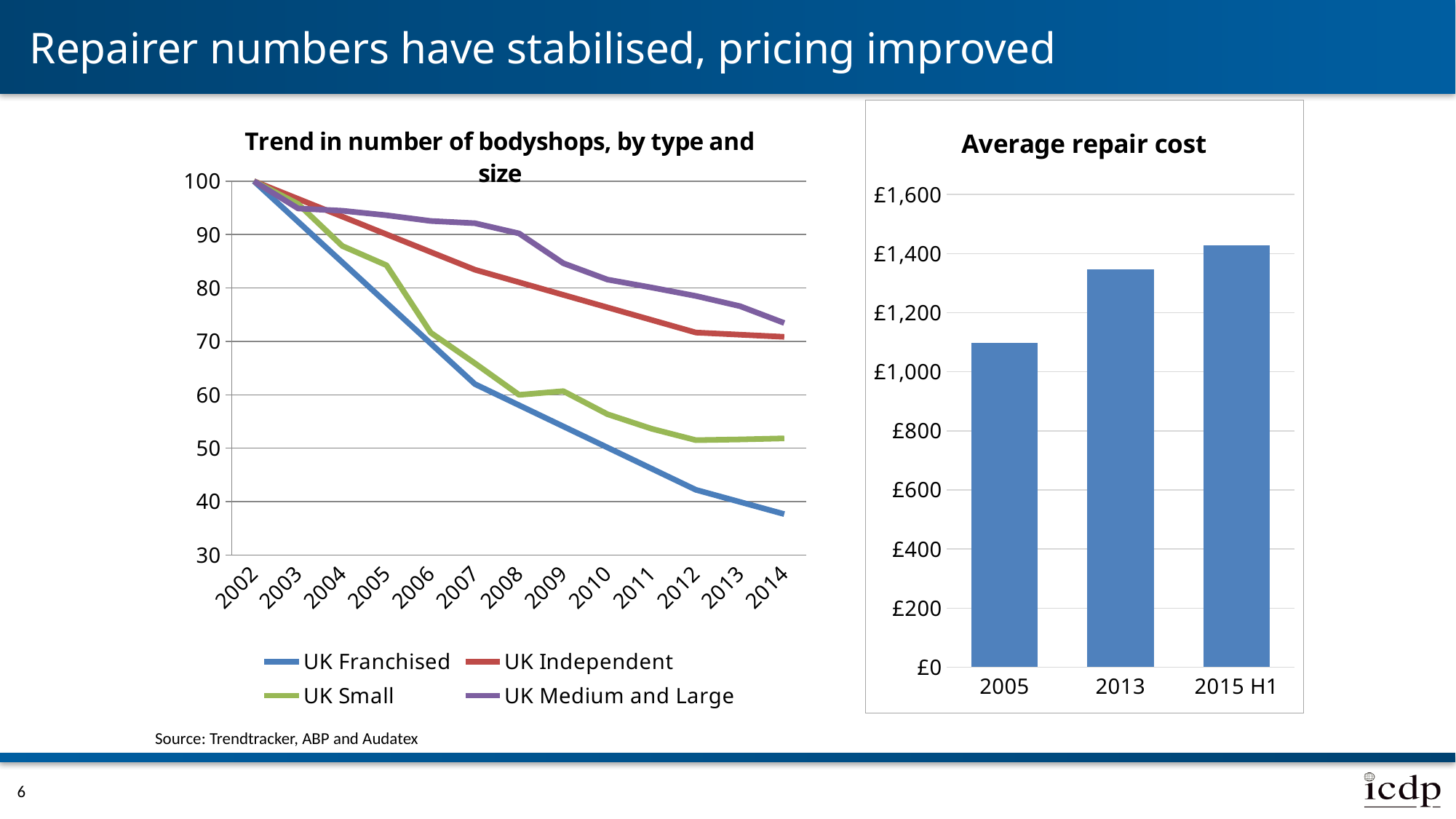
How many categories are shown on the x axis of the 'Average repair cost' chart? 3 In the 'Trend in number of bodyshops, by type and size' chart, which series has the highest value in 2014? UK Medium and Large What type of chart is the 'Trend in number of bodyshops, by type and size' chart? line chart In the 'Average repair cost' chart, do the values rise or fall from 2005 to 2015 H1? rise In the 'Trend in number of bodyshops, by type and size' chart, do the values for UK Franchised rise or fall from 2002 to 2014? fall What type of chart is the 'Average repair cost' chart? bar chart In the 'Trend in number of bodyshops, by type and size' chart, is the value for UK Franchised in 2014 greater or less than 40? less How many series does the legend of the 'Trend in number of bodyshops, by type and size' chart list? 4 In the 'Average repair cost' chart, which category has the highest value? 2015 H1 In the 'Trend in number of bodyshops, by type and size' chart, which series has the lowest value in 2014? UK Franchised In the 'Average repair cost' chart, is the value for 2005 greater or less than £1,000? greater In the 'Trend in number of bodyshops, by type and size' chart, is the value for UK Small in 2014 greater or less than 50? greater